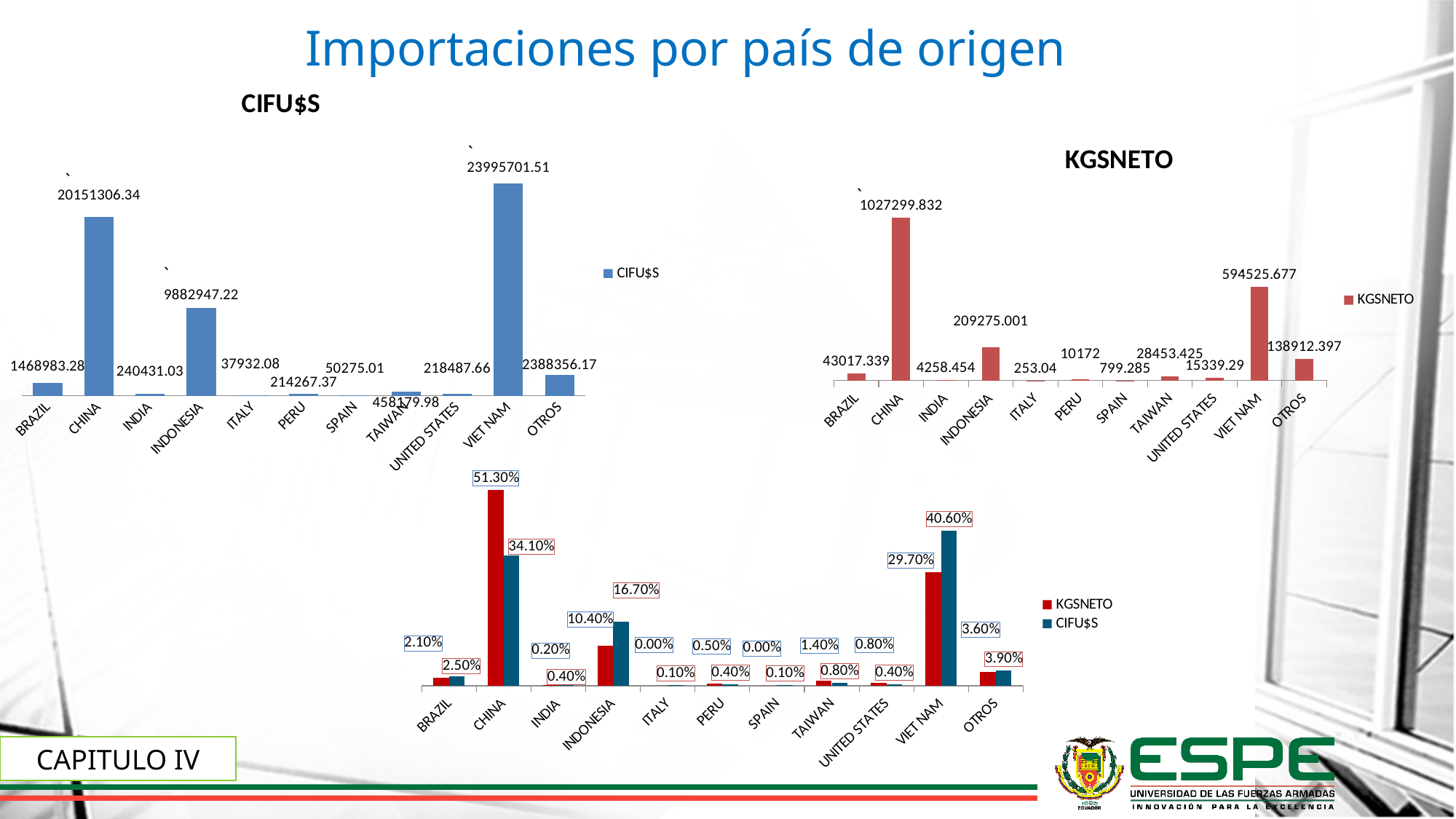
In the KGSNETO chart, which country has the highest value? CHINA In the KGSNETO chart, what is the value for CHINA? 1027299.832 In the KGSNETO chart, which is larger, the value for INDONESIA or the value for BRAZIL? INDONESIA In the bottom chart, what is the KGSNETO percentage for CHINA? 51.30% In the bottom chart, how many series does the legend list? 2 In the KGSNETO chart, what is the value for OTROS? 138912.397 In the CIFU$S chart, what is the value for VIET NAM? 23995701.51 In the bottom chart, what is the CIFU$S percentage for VIET NAM? 40.60% How many countries/categories are shown on the x axis of the CIFU$S chart? 11 In the CIFU$S chart, what is the value for INDONESIA? 9882947.22 In the CIFU$S chart, which country has the highest value? VIET NAM What type of chart is the KGSNETO chart? Bar chart